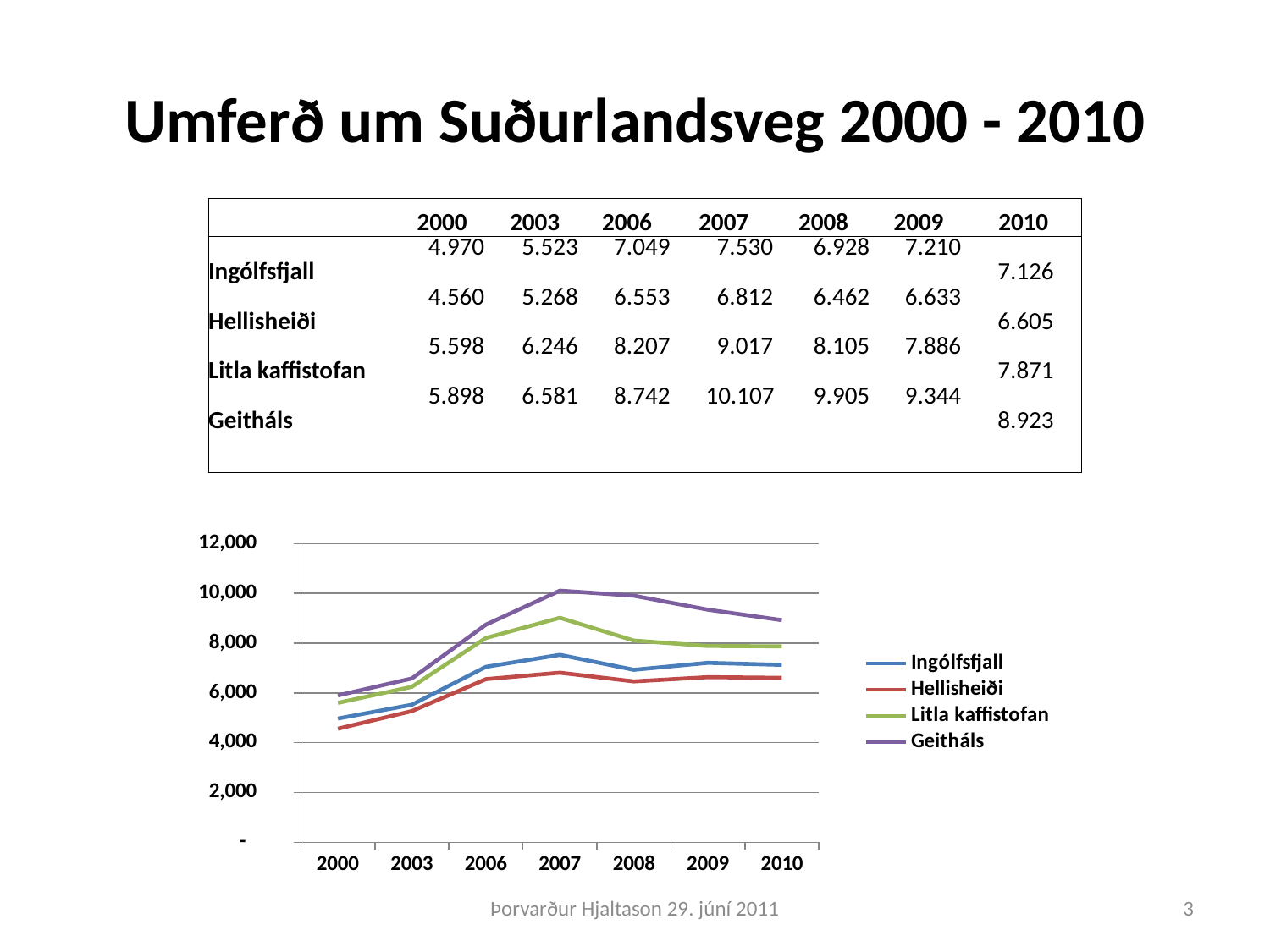
What is the value for Ingólfsfjall in 2000? 4.970 What kind of chart is shown on the slide? line chart Is the value for Hellisheiði in 2000 greater or less than 6,000? less What colour is the Geitháls line in the chart? purple What is the value for Geitháls in 2007? 10.107 Does the Geitháls line rise or fall from 2007 to 2010? fall Which is larger in 2006, Litla kaffistofan or Ingólfsfjall? Litla kaffistofan What is the difference between the Geitháls and Ingólfsfjall values in 2010? 1.797 How many years are plotted along the x axis of the chart? 7 Which series has the highest value in 2007? Geitháls Which series has the lowest values across the chart? Hellisheiði How many series does the chart legend list? 4